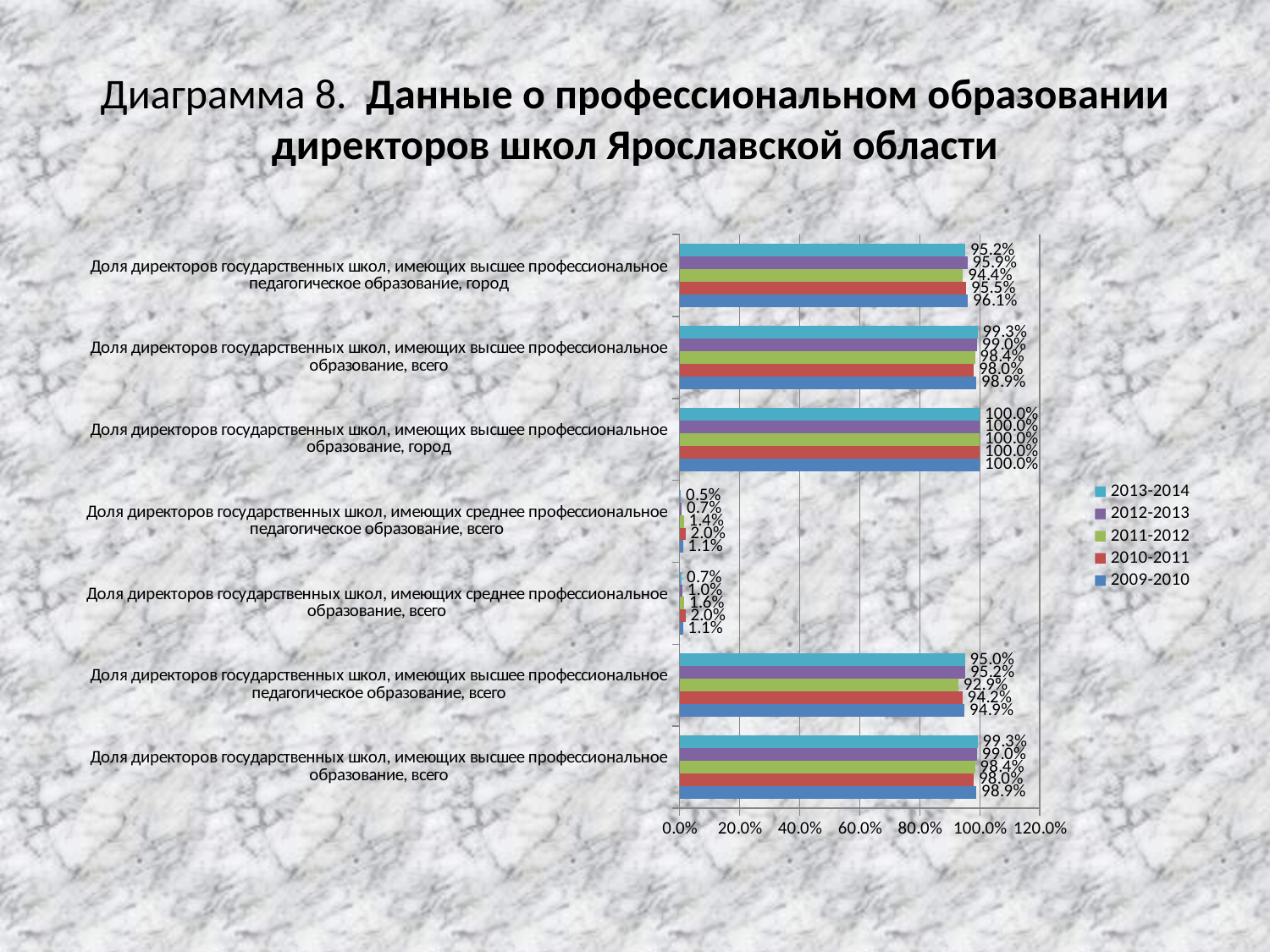
What is the 2010-2011 value for 'Доля директоров государственных школ, имеющих среднее профессиональное педагогическое образование, всего'? 2.0% In 2013-2014, which is larger: the value for 'среднее профессиональное образование, всего' or for 'среднее профессиональное педагогическое образование, всего'? среднее профессиональное образование, всего What is the 2013-2014 value for 'Доля директоров государственных школ, имеющих высшее профессиональное педагогическое образование, город'? 95.2% For 'Доля директоров государственных школ, имеющих высшее профессиональное педагогическое образование, всего', how much higher is the 2009-2010 value than the 2011-2012 value? 2.0 percentage points What is the 2011-2012 value for 'Доля директоров государственных школ, имеющих высшее профессиональное педагогическое образование, всего'? 92.9% How many series does the legend list? 5 What is the 2009-2010 value for 'Доля директоров государственных школ, имеющих высшее профессиональное педагогическое образование, город'? 96.1% How many categories are plotted on the vertical axis of the chart? 7 What is the 2012-2013 value for 'Доля директоров государственных школ, имеющих высшее профессиональное образование, город'? 100.0% For 'Доля директоров государственных школ, имеющих высшее профессиональное педагогическое образование, всего', which year has the highest value? 2012-2013 What kind of chart is shown on the slide? Bar chart Is the 2011-2012 value for 'Доля директоров государственных школ, имеющих высшее профессиональное педагогическое образование, город' greater or less than 80.0%? greater